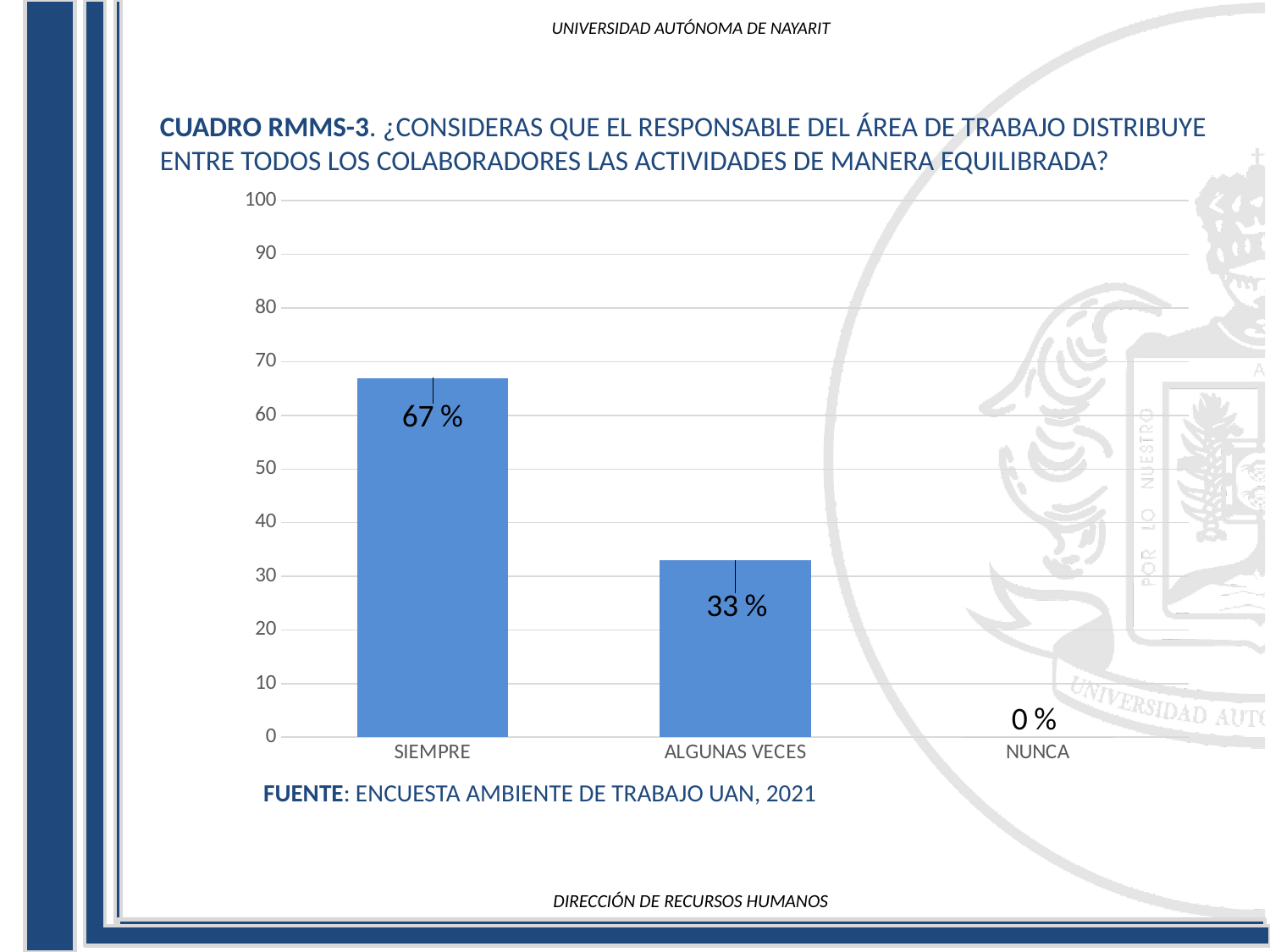
Is the value for SIEMPRE greater or less than 50? greater What is the difference between the values for SIEMPRE and ALGUNAS VECES? 34 % Which category has the highest value? SIEMPRE What kind of chart is shown on the slide? Bar chart How many categories are shown on the x axis? 3 What is the value for ALGUNAS VECES? 33 % Which is larger, the value for SIEMPRE or the value for ALGUNAS VECES? SIEMPRE What is the value for NUNCA? 0 % Which category has the lowest value? NUNCA What is the value for SIEMPRE? 67 % Is the value for ALGUNAS VECES greater or less than 40? less What source is cited below the chart? ENCUESTA AMBIENTE DE TRABAJO UAN, 2021